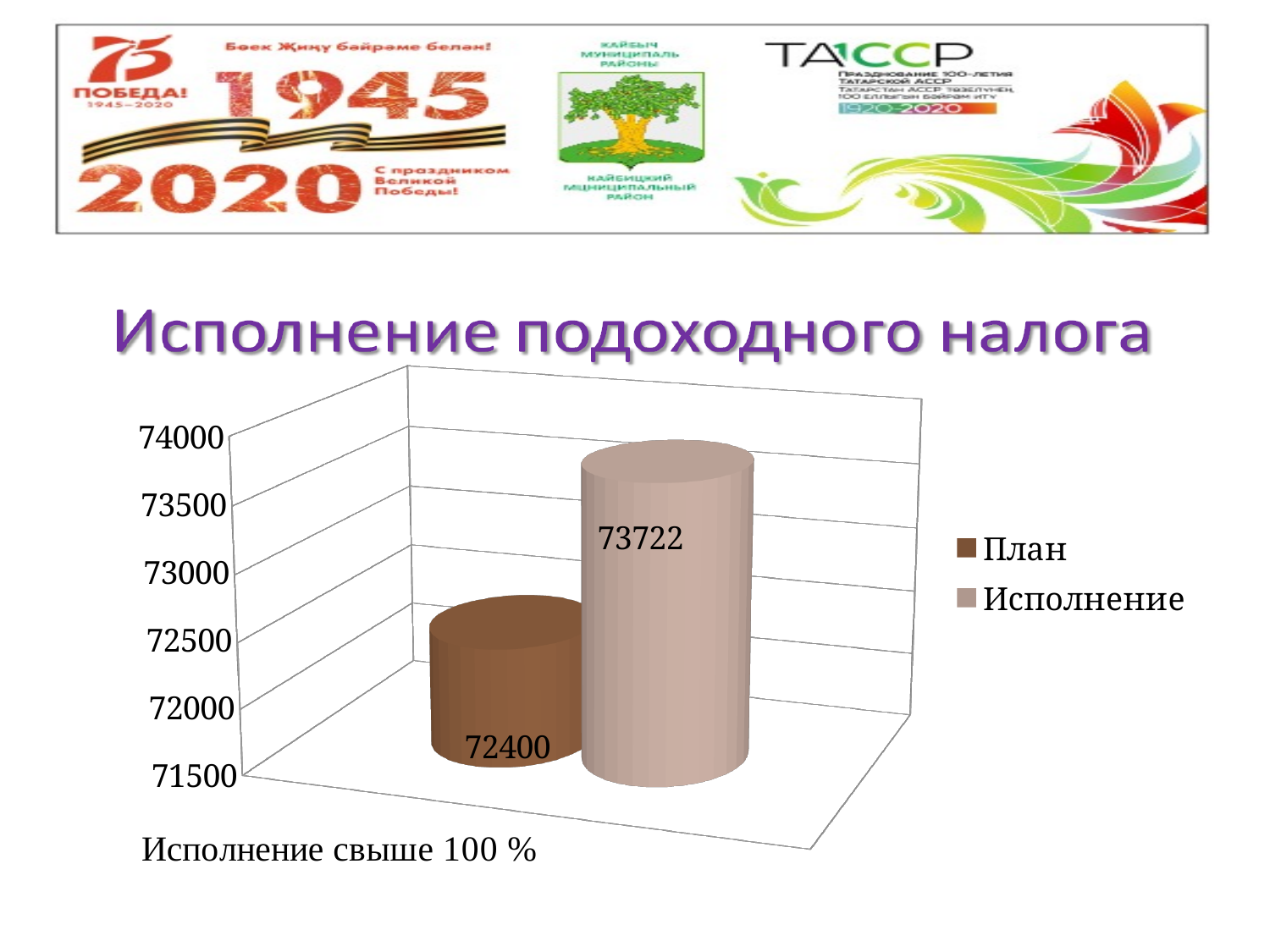
What is the difference between Исполнение and План? 1322 Which series has the lowest value? План Is the value for Исполнение greater or less than 73500? greater What is the value for Исполнение (Execution)? 73722 How many series does the legend list? 2 Which series has the higher value, План or Исполнение? Исполнение Is the value for План greater or less than 73000? less What kind of chart is shown on the slide? bar chart What is the title of the chart? Исполнение подоходного налога What is the highest value shown on the vertical axis? 74000 How many bars are plotted in the chart? 2 What is the value for План (Plan)? 72400